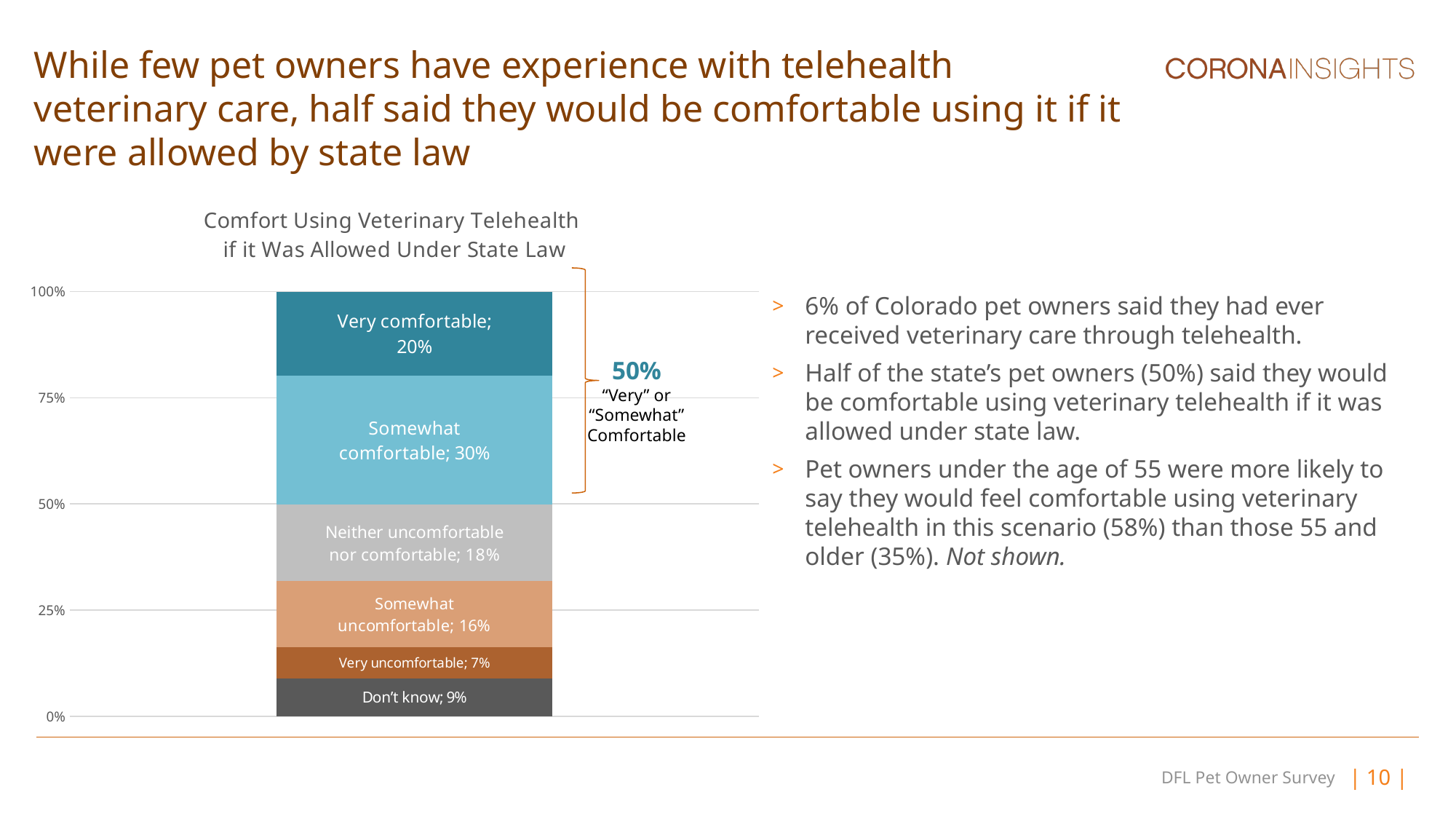
How many response categories are shown in the stacked bar? 6 What is the difference between the 'Somewhat comfortable' and 'Somewhat uncomfortable' percentages? 14% Which response category has the smallest share in the chart? Very uncomfortable What combined percentage is shown for 'Very' or 'Somewhat' comfortable? 50% Which response category has the largest share in the chart? Somewhat comfortable What percentage of pet owners said they would be somewhat comfortable? 30% What percentage of pet owners said they would be very comfortable using veterinary telehealth? 20% Which is larger: the share for 'Neither uncomfortable nor comfortable' or the share for 'Somewhat uncomfortable'? Neither uncomfortable nor comfortable What is the title of the chart? Comfort Using Veterinary Telehealth if it Was Allowed Under State Law What percentage of pet owners said they would be very uncomfortable? 7% What type of chart is shown on the slide? Stacked bar chart What percentage of pet owners answered 'Don't know'? 9%